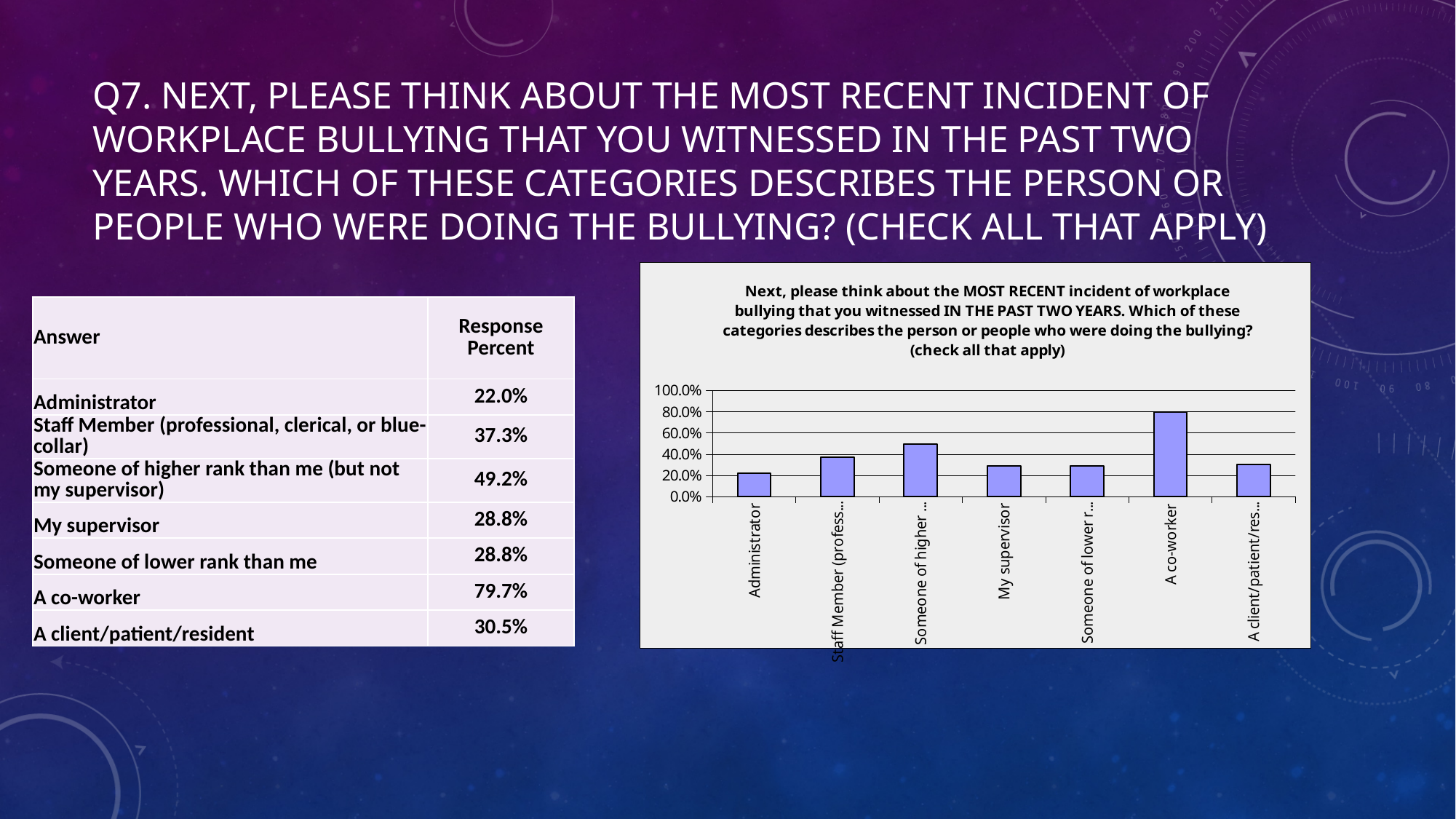
What is the highest value shown on the chart's vertical axis? 100.0% Is the value for A co-worker greater or less than 60.0%? greater Is the value for My supervisor greater or less than 40.0%? less Which category has the lowest value in the chart? Administrator How many categories are plotted in the bar chart? 7 What is the response percent for Administrator? 22.0% What is the response percent for A co-worker? 79.7% What is the difference between the response percent for A co-worker and the response percent for Administrator? 57.7% Which category has the highest value in the chart? A co-worker What type of chart is shown on the slide? bar chart What is the response percent for A client/patient/resident? 30.5% Which is larger, the value for Staff Member (professional, clerical, or blue-collar) or the value for Someone of higher rank than me (but not my supervisor)? Someone of higher rank than me (but not my supervisor)